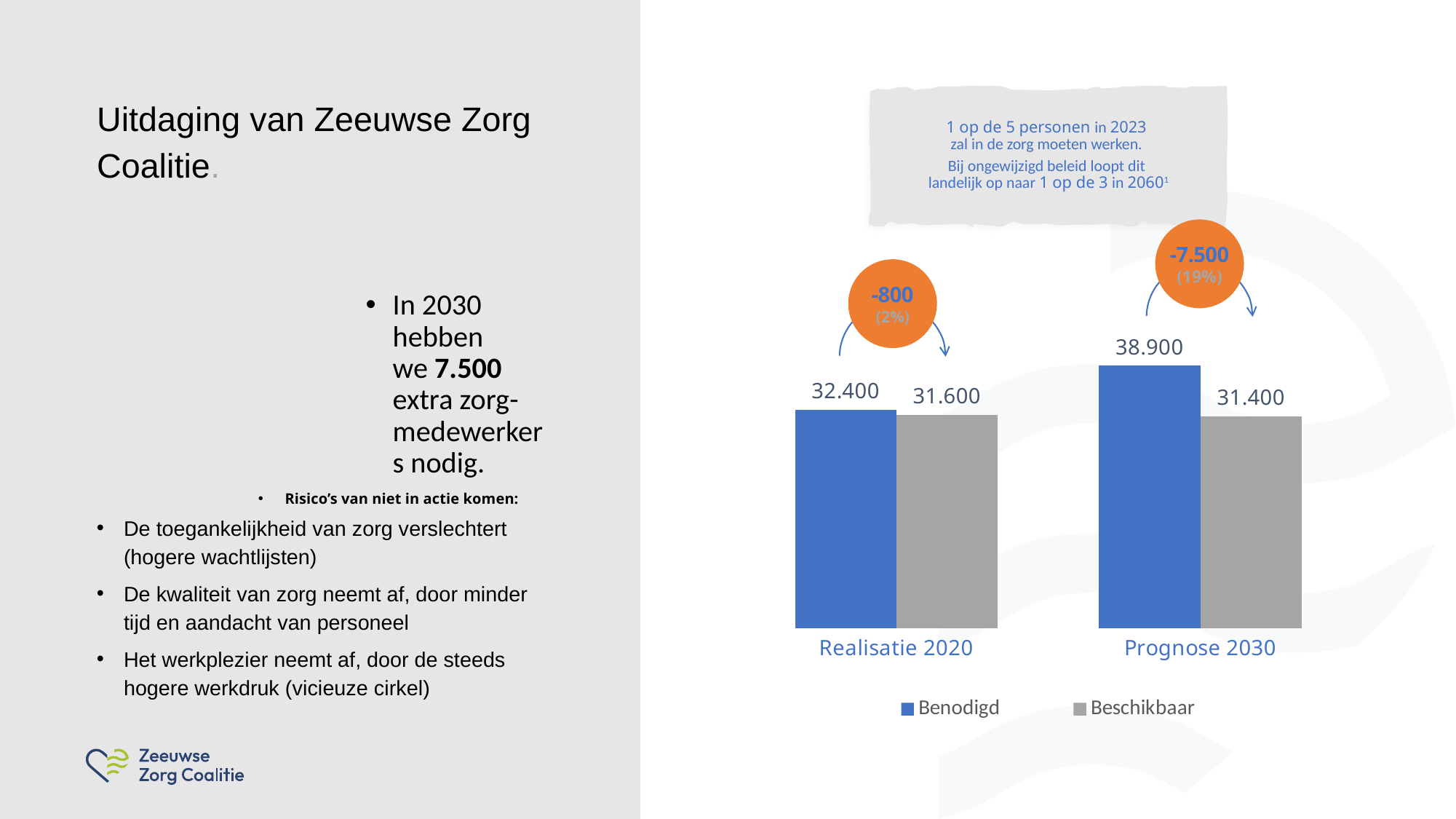
What is the difference between Benodigd and Beschikbaar for Realisatie 2020? 800 What kind of chart is shown on the slide? Bar chart What is the value of Beschikbaar for Prognose 2030? 31.400 What is the difference between Benodigd and Beschikbaar for Prognose 2030? 7.500 What is the value of Beschikbaar for Realisatie 2020? 31.600 Which bar in the chart has the lowest value? Beschikbaar, Prognose 2030 What is the value of Benodigd for Realisatie 2020? 32.400 Which is larger: Benodigd for Realisatie 2020 or Benodigd for Prognose 2030? Benodigd for Prognose 2030 Which bar in the chart has the highest value? Benodigd, Prognose 2030 How many series does the chart legend list? 2 How many categories are shown on the x axis of the chart? 2 What is the value of Benodigd for Prognose 2030? 38.900